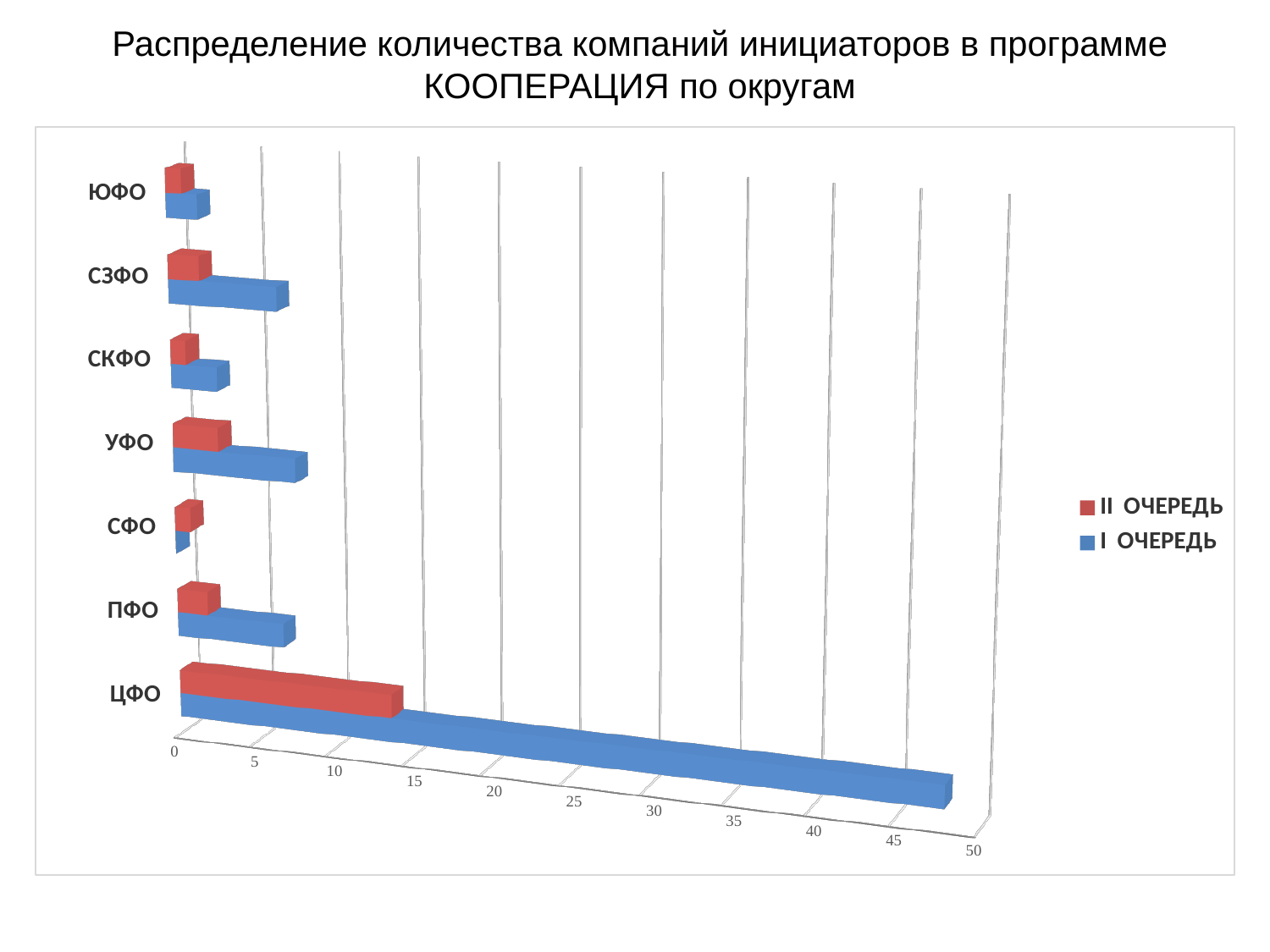
Which is larger for I ОЧЕРЕДЬ: УФО or СКФО? УФО Is the value for ЦФО in the II ОЧЕРЕДЬ series greater or less than 20? less Is the value for УФО in the I ОЧЕРЕДЬ series greater or less than 10? less How many series does the legend list? 2 What kind of chart is shown on the slide? bar chart Which is larger for I ОЧЕРЕДЬ: СЗФО or ЮФО? СЗФО Which colour represents the II ОЧЕРЕДЬ series? red Which district has the highest value for I ОЧЕРЕДЬ? ЦФО Which district has the highest value for II ОЧЕРЕДЬ? ЦФО Which district has the lowest value for I ОЧЕРЕДЬ? СФО How many districts (categories) are shown on the chart? 7 Is the value for ЦФО in the I ОЧЕРЕДЬ series greater or less than 40? greater